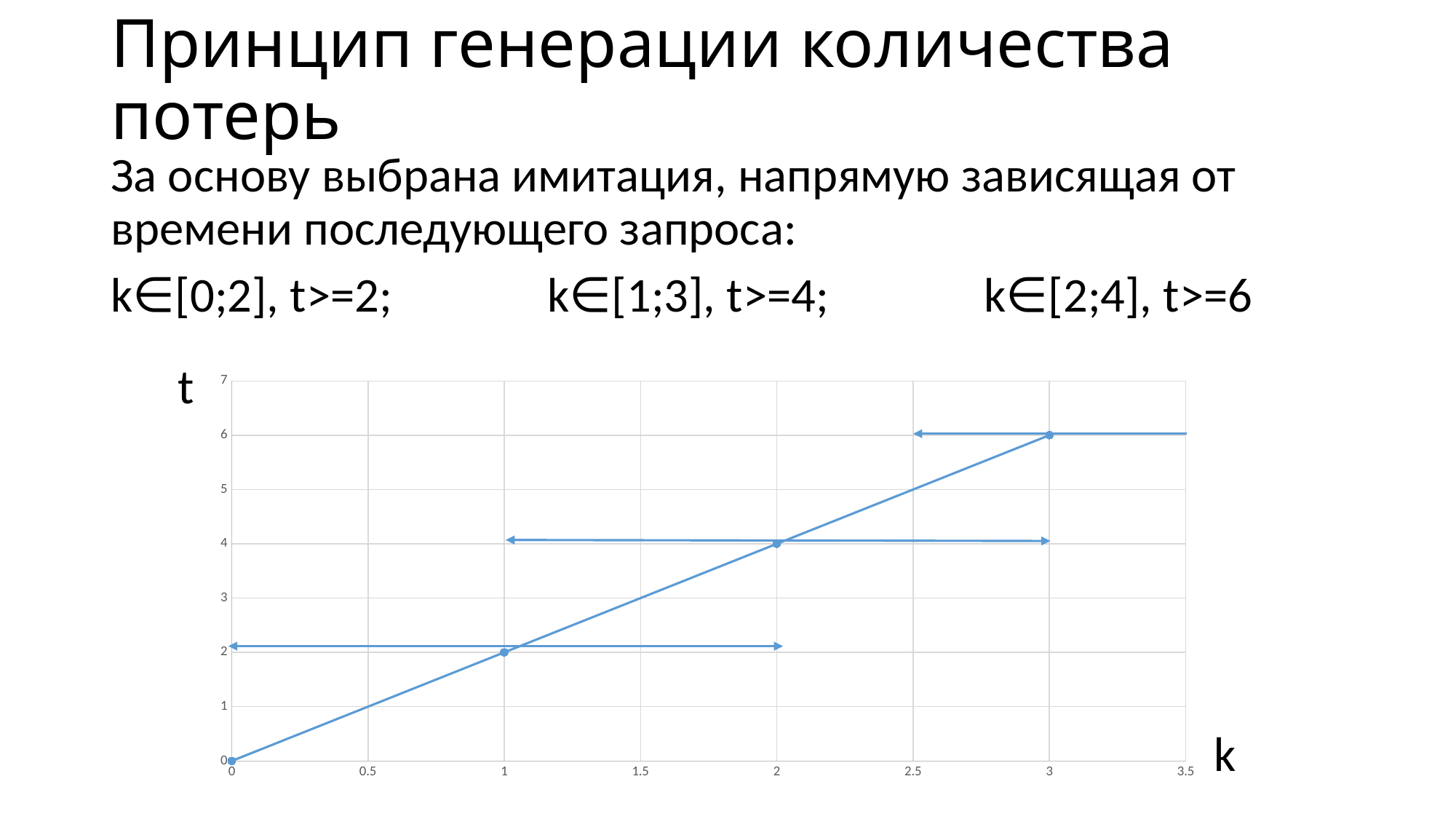
What is the value of t at k = 1 on the chart? 2 Does t rise or fall as k increases along the x axis? rises At which value of k is t highest on the chart? 3 What is the label of the vertical axis of the chart? t What is the value of t at k = 2 on the chart? 4 What is the value of t at k = 0 on the chart? 0 At which value of k is t lowest on the chart? 0 What is the value of t at k = 3 on the chart? 6 What kind of chart is shown on the slide? line chart What is the difference between t at k = 3 and t at k = 1? 4 Which is larger: t at k = 2 or t at k = 1? t at k = 2 How many data points are plotted on the line in the chart? 4